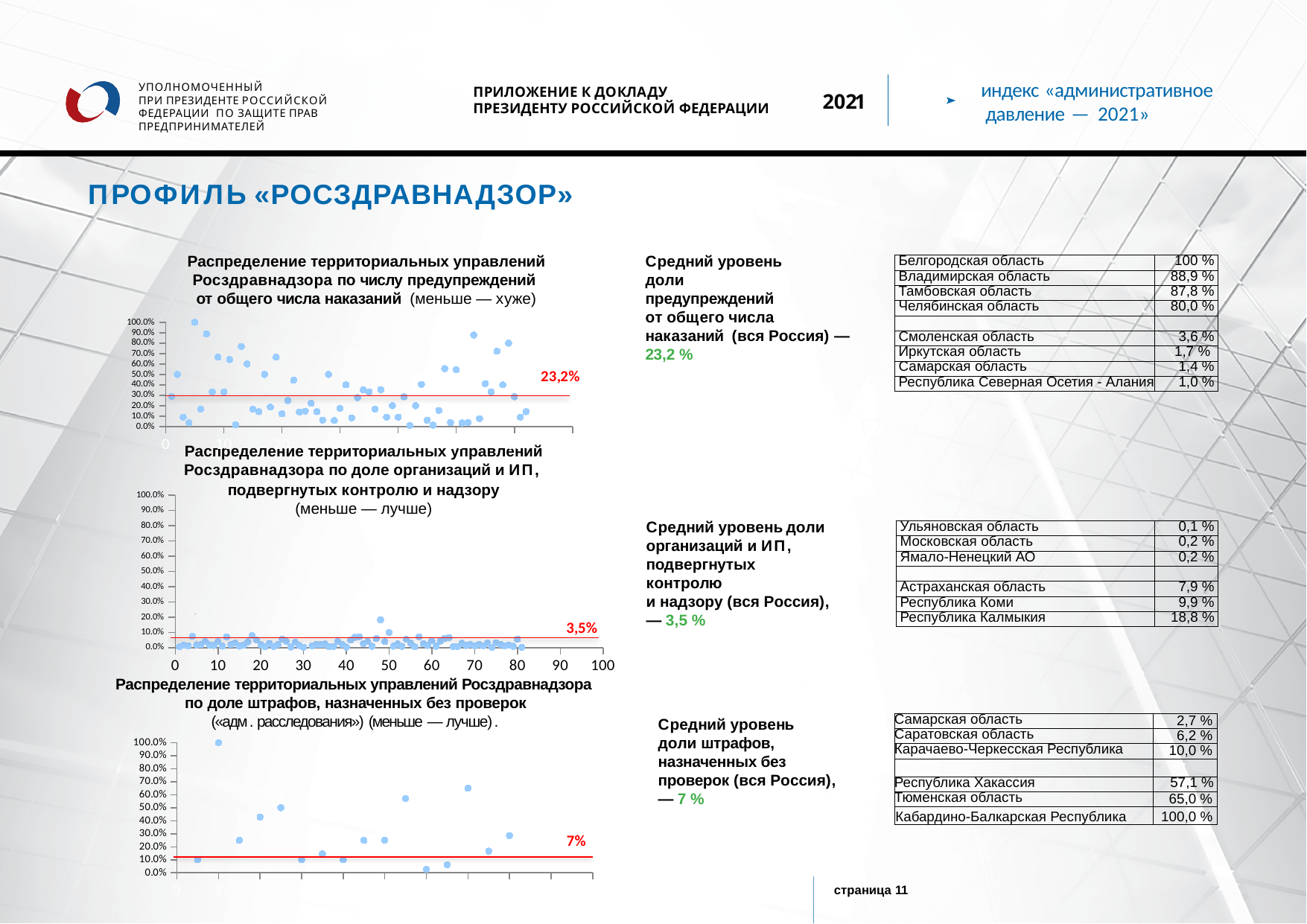
In the bottom chart (по доле штрафов, назначенных без проверок), what value is printed next to the red reference line? 7% In the middle chart (по доле организаций и ИП), is the highest plotted point greater or less than 30%? less How many scatter charts are shown on the slide? 3 What is the difference between the reference line value in the top chart (23,2%) and the reference line value in the bottom chart (7%)? 16,2% In the middle chart, what is the largest value shown on the x axis? 100 In the top chart (по числу предупреждений), what value is printed next to the horizontal reference line? 23,2% Which chart has the higher labelled reference line: the top chart (23,2%) or the bottom chart (7%)? the top chart In the bottom chart (по доле штрафов), is the highest plotted point greater or less than 90%? greater What is the topmost tick label on the y axis of the bottom chart? 100.0% What kind of chart is the top chart, 'Распределение территориальных управлений Росздравнадзора по числу предупреждений от общего числа наказаний'? scatter chart In the middle chart (по доле организаций и ИП, подвергнутых контролю и надзору), what value is printed next to the red reference line? 3,5%